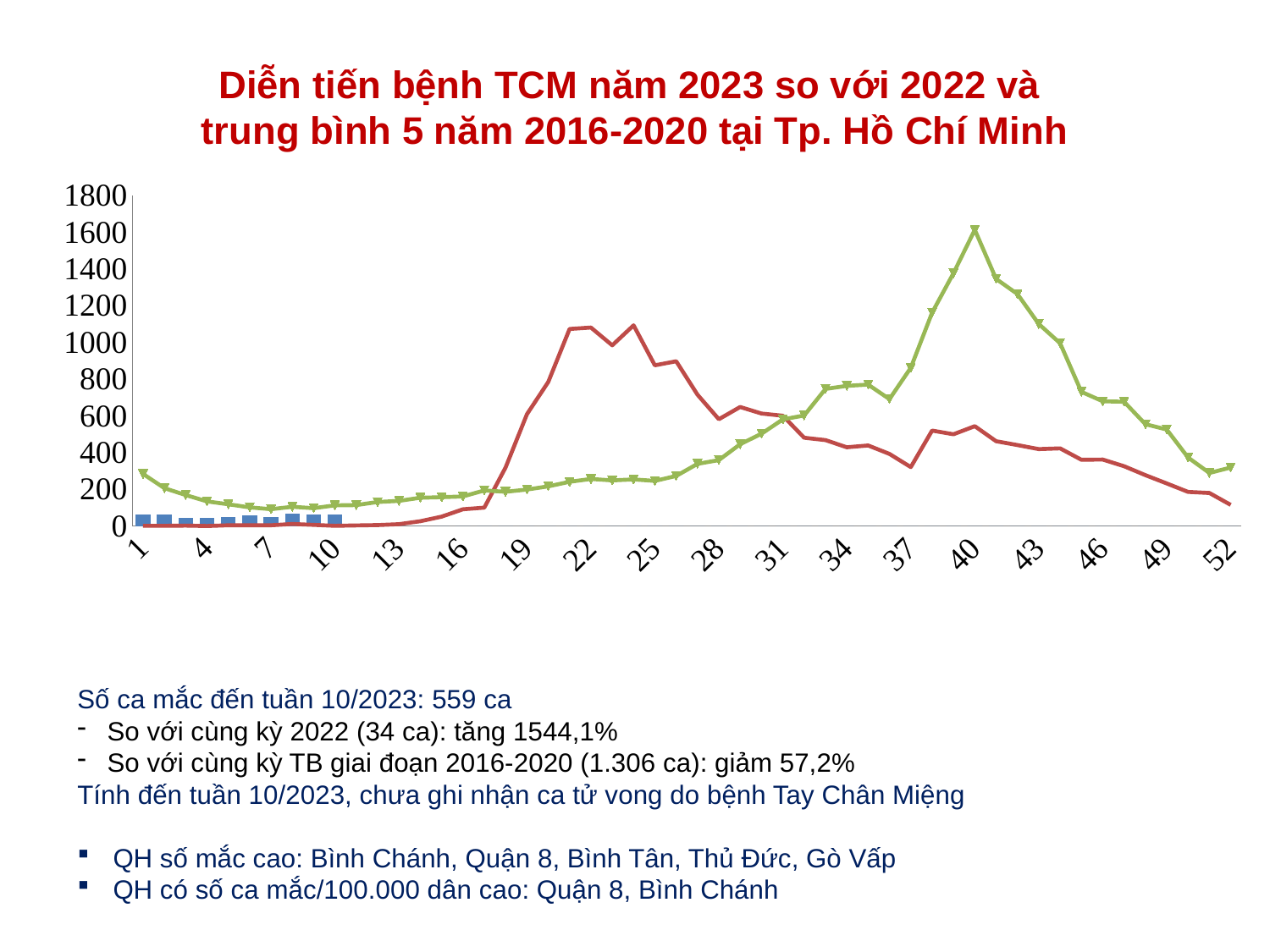
What is the title of the chart? Diễn tiến bệnh TCM năm 2023 so với 2022 và trung bình 5 năm 2016-2020 tại Tp. Hồ Chí Minh Is the value of the red line at week 22 greater or less than 1000? greater What is the highest value shown on the vertical axis of the chart? 1800 At week 40, which is larger: the green line or the red line? the green line Is the value of the green line at week 1 greater or less than 400? less How many weeks are plotted along the x axis of the chart? 52 Is the value of the red line at week 52 greater or less than 200? less At week 22, which is larger: the red line or the green line? the red line Does the green line rise or fall from week 40 to week 52? fall At which week does the green line with markers reach its highest point? 40 Does the red line rise or fall from week 17 to week 22? rise